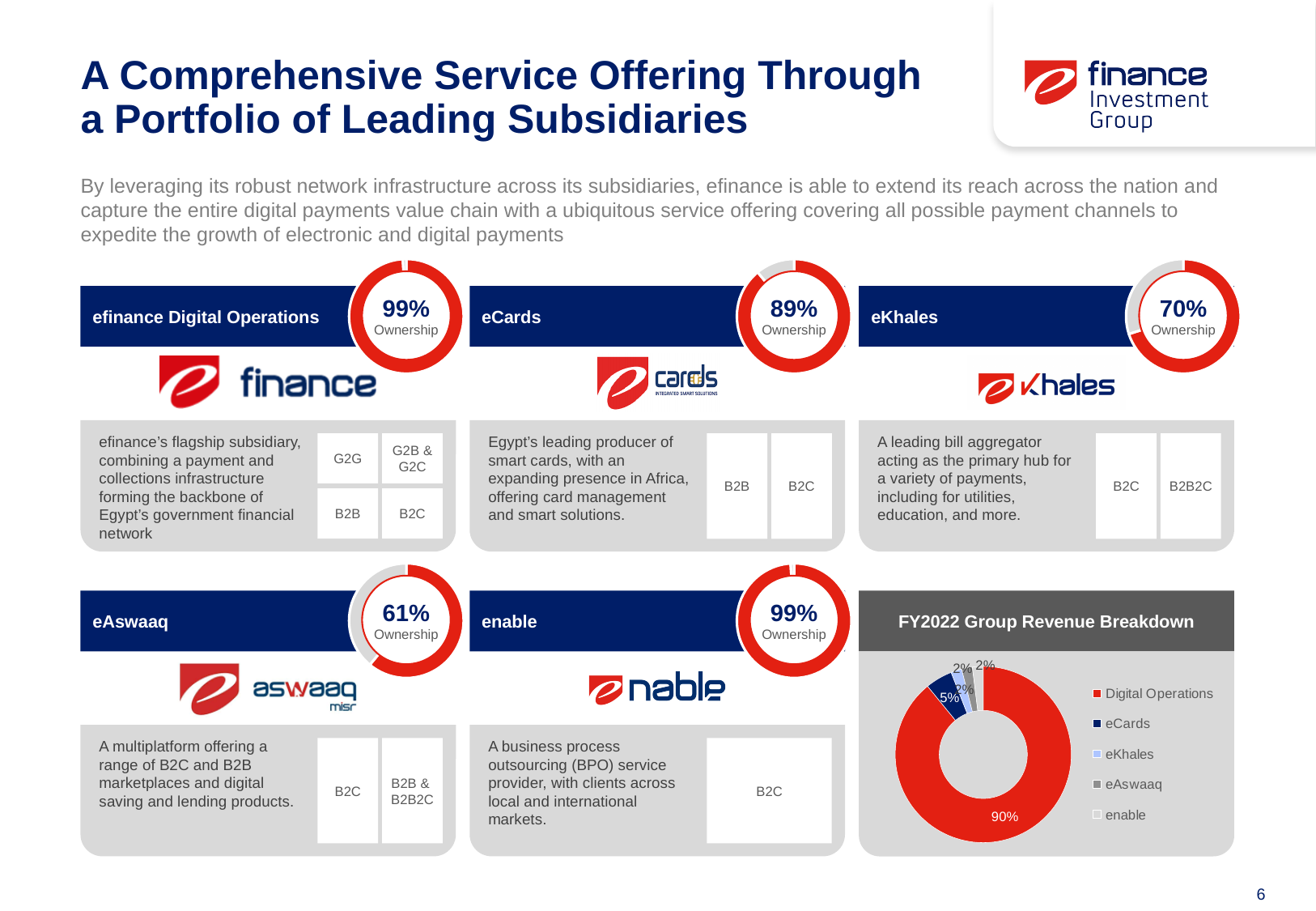
In the FY2022 Group Revenue Breakdown chart, how many segments does the legend list? 5 Among the ownership ring charts shown, which subsidiary has the lowest ownership percentage? eAswaaq In the FY2022 Group Revenue Breakdown chart, what share of revenue comes from eCards? 5% In the FY2022 Group Revenue Breakdown chart, what is the last entry listed in the legend? enable In the FY2022 Group Revenue Breakdown chart, which segment has the largest share of revenue? Digital Operations In the FY2022 Group Revenue Breakdown chart, what share of revenue comes from Digital Operations? 90% According to the ownership ring chart for eCards, what is efinance's ownership percentage? 89% In the FY2022 Group Revenue Breakdown chart, what is the difference in percentage points between the Digital Operations share and the eCards share? 85 percentage points What kind of chart is the FY2022 Group Revenue Breakdown? Donut (pie) chart In the FY2022 Group Revenue Breakdown chart, which has a larger share of revenue, eCards or eKhales? eCards According to the ownership ring chart for eKhales, what is efinance's ownership percentage? 70% In the FY2022 Group Revenue Breakdown chart, which colour represents Digital Operations? Red